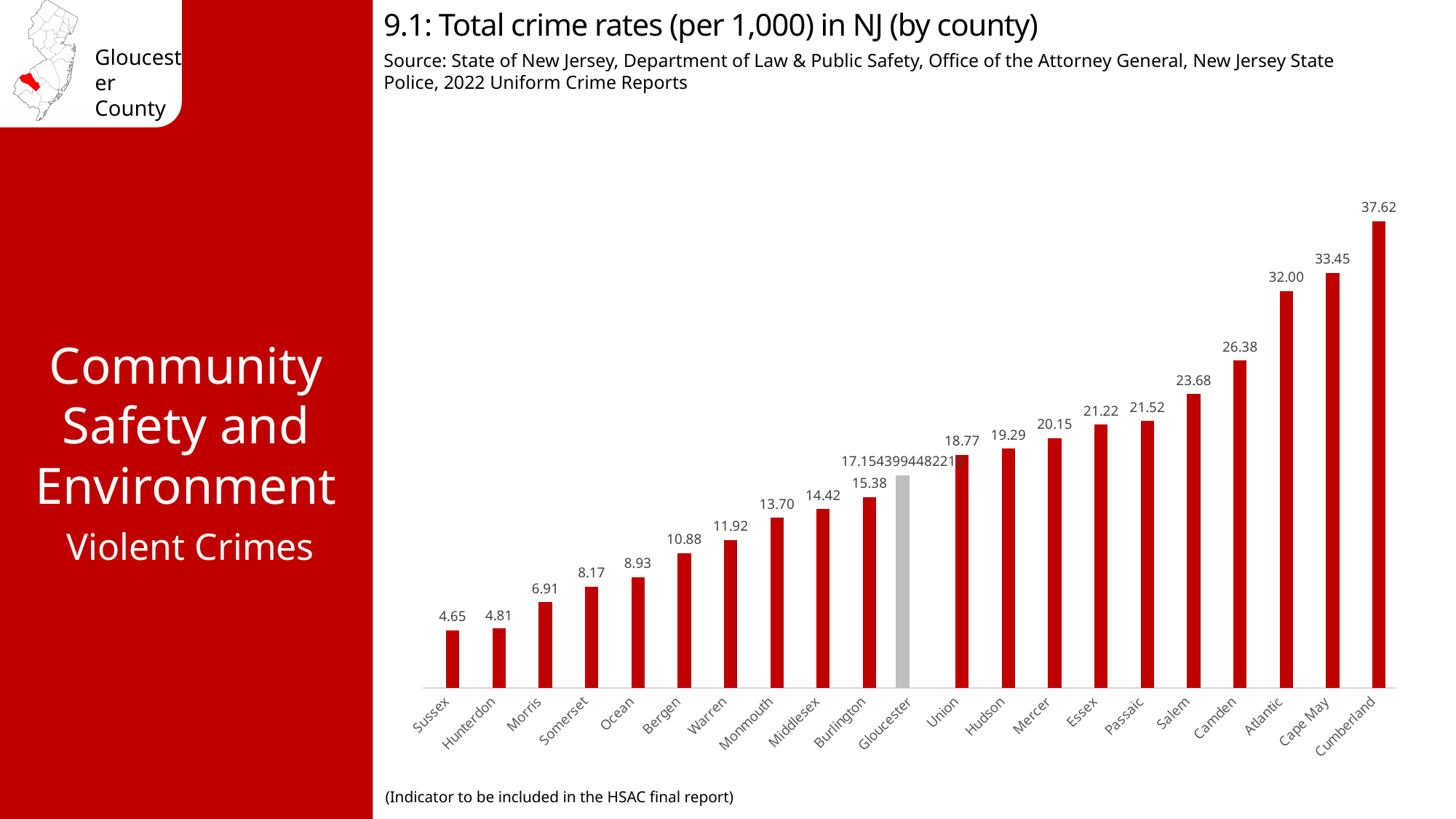
Which county's bar is shown in grey instead of red? Gloucester What is the total crime rate per 1,000 for Camden county? 26.38 What is the difference between the crime rates of Cumberland and Sussex counties? 32.97 What is the difference between the crime rates of Cape May and Atlantic counties? 1.45 Which county has a higher crime rate, Salem or Camden? Camden What type of chart is used to show the crime rates? Bar chart Which county has the highest total crime rate? Cumberland Which county has a higher crime rate, Hudson or Union? Hudson What is the total crime rate per 1,000 for Sussex county? 4.65 What is the total crime rate per 1,000 for Cumberland county? 37.62 How many counties are shown in the chart? 21 Which county has the lowest total crime rate? Sussex